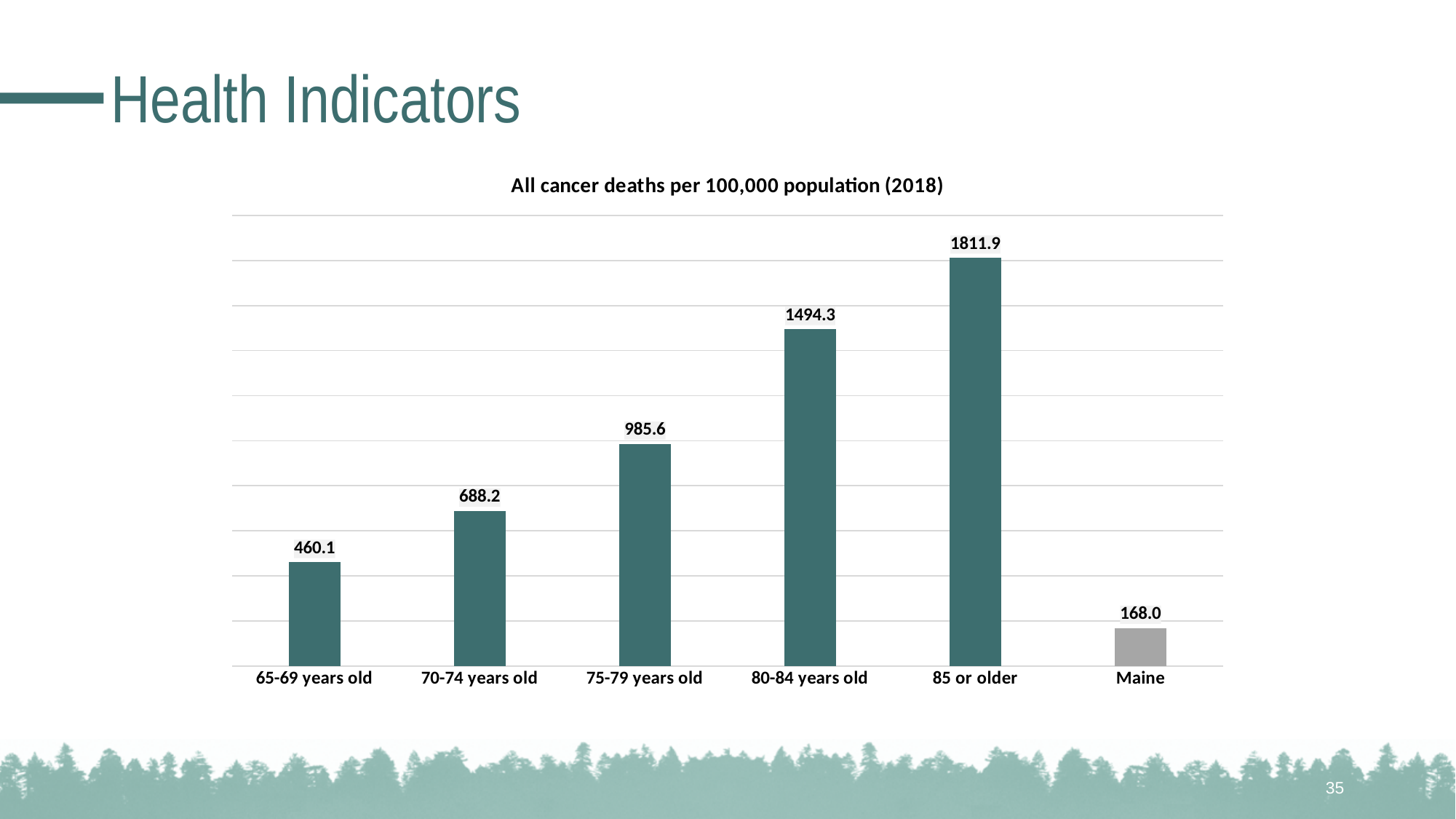
What kind of chart is this? bar chart How many categories are shown on the x axis? 6 What is the title of the chart? All cancer deaths per 100,000 population (2018) What is the value for 65-69 years old? 460.1 Which is larger, the value for 75-79 years old or the value for 70-74 years old? 75-79 years old What is the value for 80-84 years old? 1494.3 Which category has the highest value? 85 or older What is the difference between the values for 70-74 years old and 65-69 years old? 228.1 What is the value for Maine? 168.0 Do the values rise or fall across the age groups from 65-69 years old to 85 or older? rise Which category has the lowest value? Maine What is the difference between the values for 85 or older and 80-84 years old? 317.6